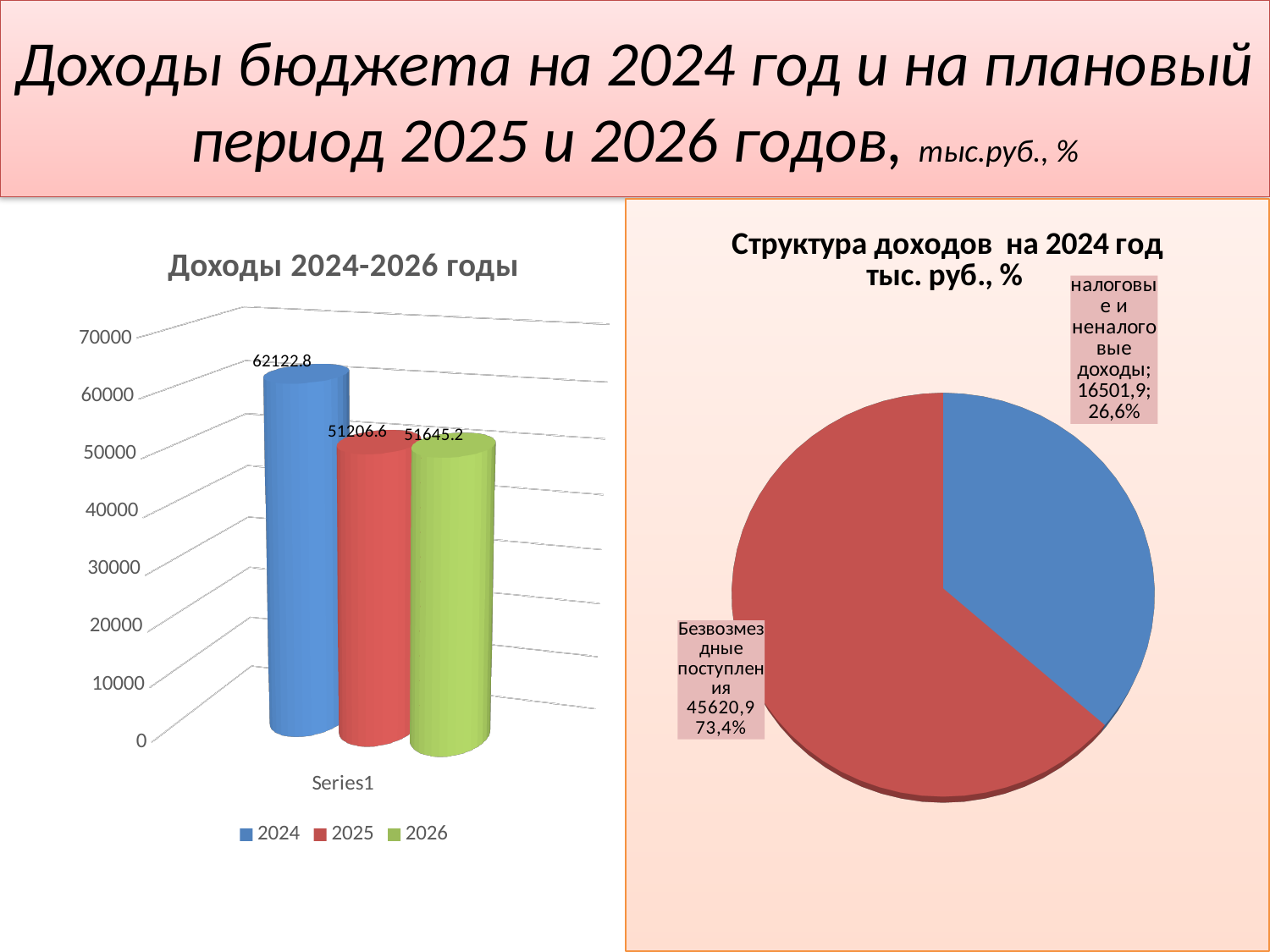
In the chart titled "Доходы 2024-2026 годы", what is the difference between the 2024 and 2025 values? 10916.2 In the pie chart "Структура доходов на 2024 год", what is the value for "налоговые и неналоговые доходы"? 16501,9 In the chart titled "Доходы 2024-2026 годы", what is the value for 2024? 62122.8 In the chart titled "Доходы 2024-2026 годы", which year has the highest value? 2024 In the pie chart "Структура доходов на 2024 год", which slice is the largest? Безвозмездные поступления In the chart titled "Доходы 2024-2026 годы", which year has the lowest value? 2025 In the chart titled "Доходы 2024-2026 годы", what is the value for 2025? 51206.6 In the chart titled "Доходы 2024-2026 годы", what is the value for 2026? 51645.2 In the chart titled "Доходы 2024-2026 годы", how many series does the legend list? 3 What kind of chart is the chart on the left side of the slide? Bar chart In the chart titled "Доходы 2024-2026 годы", which is larger, the value for 2025 or for 2026? 2026 In the pie chart "Структура доходов на 2024 год", what share do "Безвозмездные поступления" have? 73,4%